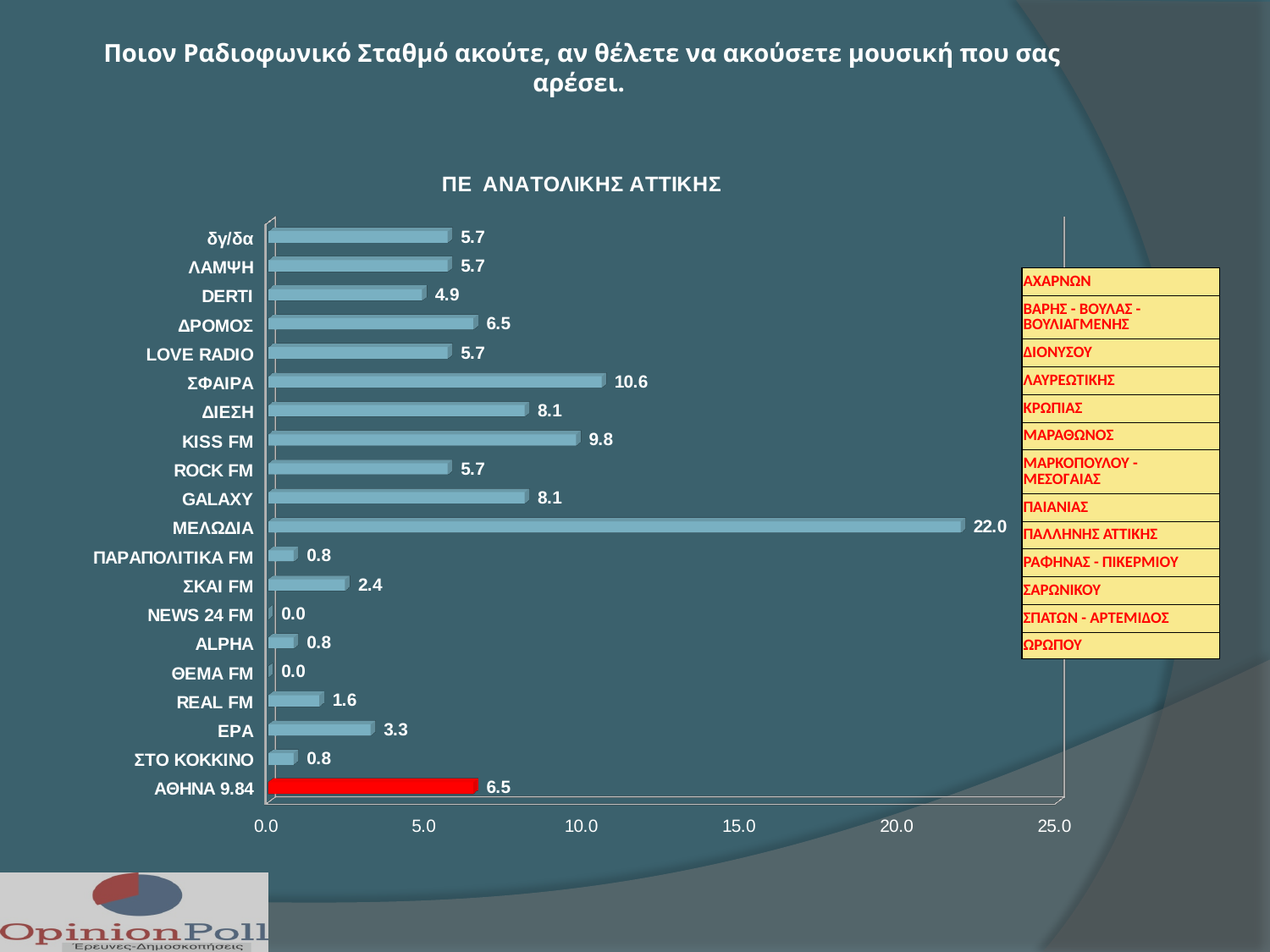
Which radio station has the highest value in the chart? ΜΕΛΩΔΙΑ What value is shown for ΑΘΗΝΑ 9.84? 6.5 What is the difference between the values for KISS FM and ΣΚΑΙ FM? 7.4 What value is shown for ΜΕΛΩΔΙΑ? 22.0 What value is shown for ΣΦΑΙΡΑ? 10.6 Which radio station's bar is coloured red? ΑΘΗΝΑ 9.84 What type of chart is shown on the slide? Bar chart What is the difference between the values for ΜΕΛΩΔΙΑ and ΣΦΑΙΡΑ? 11.4 Which has a larger value, ΔΙΕΣΗ or DERTI? ΔΙΕΣΗ Is the value for ΜΕΛΩΔΙΑ greater or less than 20.0? greater What value is shown for KISS FM? 9.8 How many radio stations (categories) are listed in the chart? 20